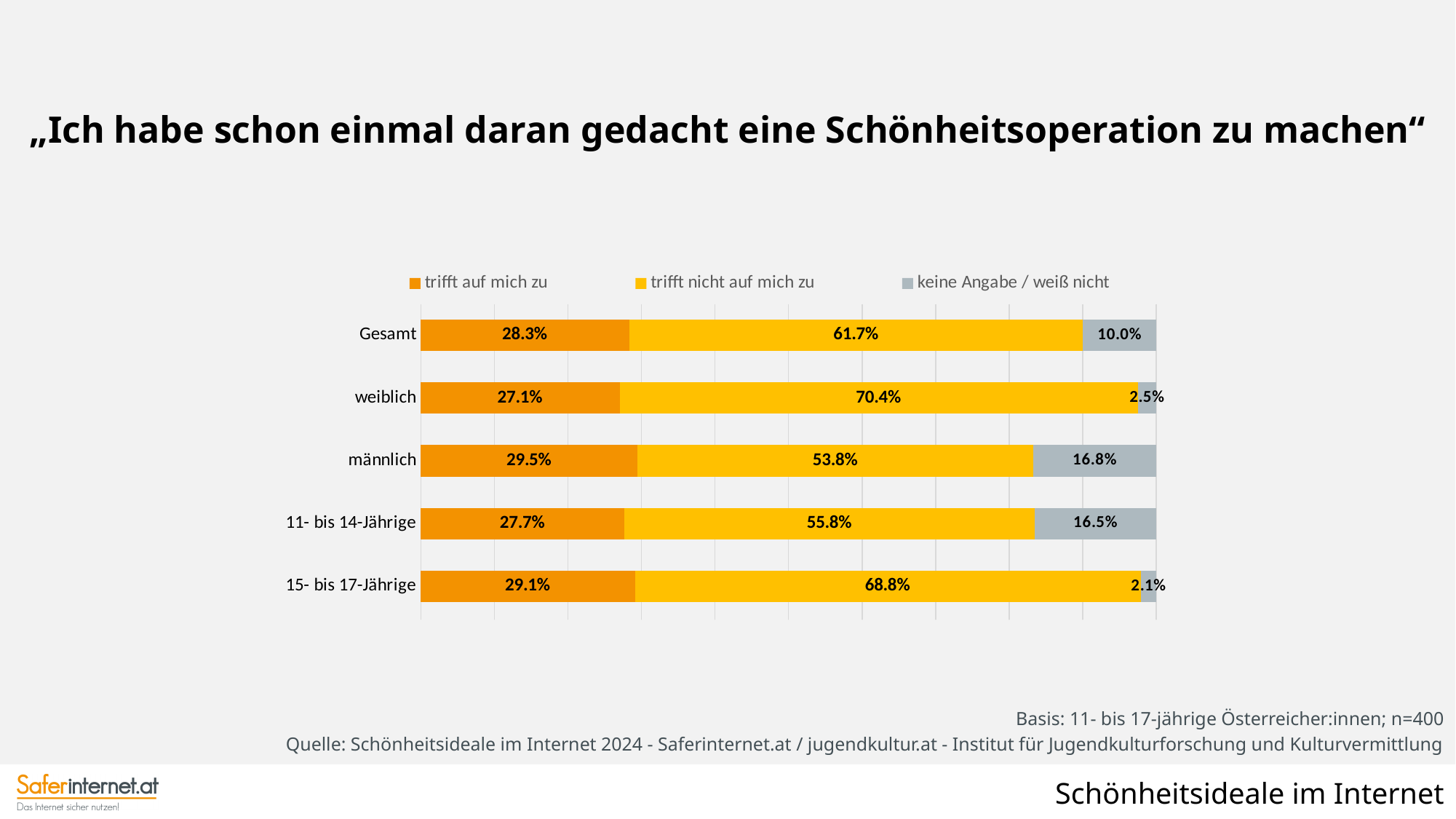
What is the difference in percentage points between the "trifft auf mich zu" values for männlich and weiblich? 2.4 What colour represents "trifft auf mich zu" in the legend? Orange What is the "trifft nicht auf mich zu" value for 15- bis 17-Jährige? 68.8% How many series does the legend list? 3 What is the "trifft nicht auf mich zu" value for weiblich? 70.4% What percentage of the Gesamt group answered "trifft auf mich zu"? 28.3% Which group has the lowest "keine Angabe / weiß nicht" value? 15- bis 17-Jährige Which group has the larger "trifft nicht auf mich zu" value, 11- bis 14-Jährige or 15- bis 17-Jährige? 15- bis 17-Jährige Which group has the highest "trifft auf mich zu" value? männlich What is the "keine Angabe / weiß nicht" value for männlich? 16.8% How many groups (bars) are shown in the chart? 5 What kind of chart is shown on the slide? Stacked bar chart